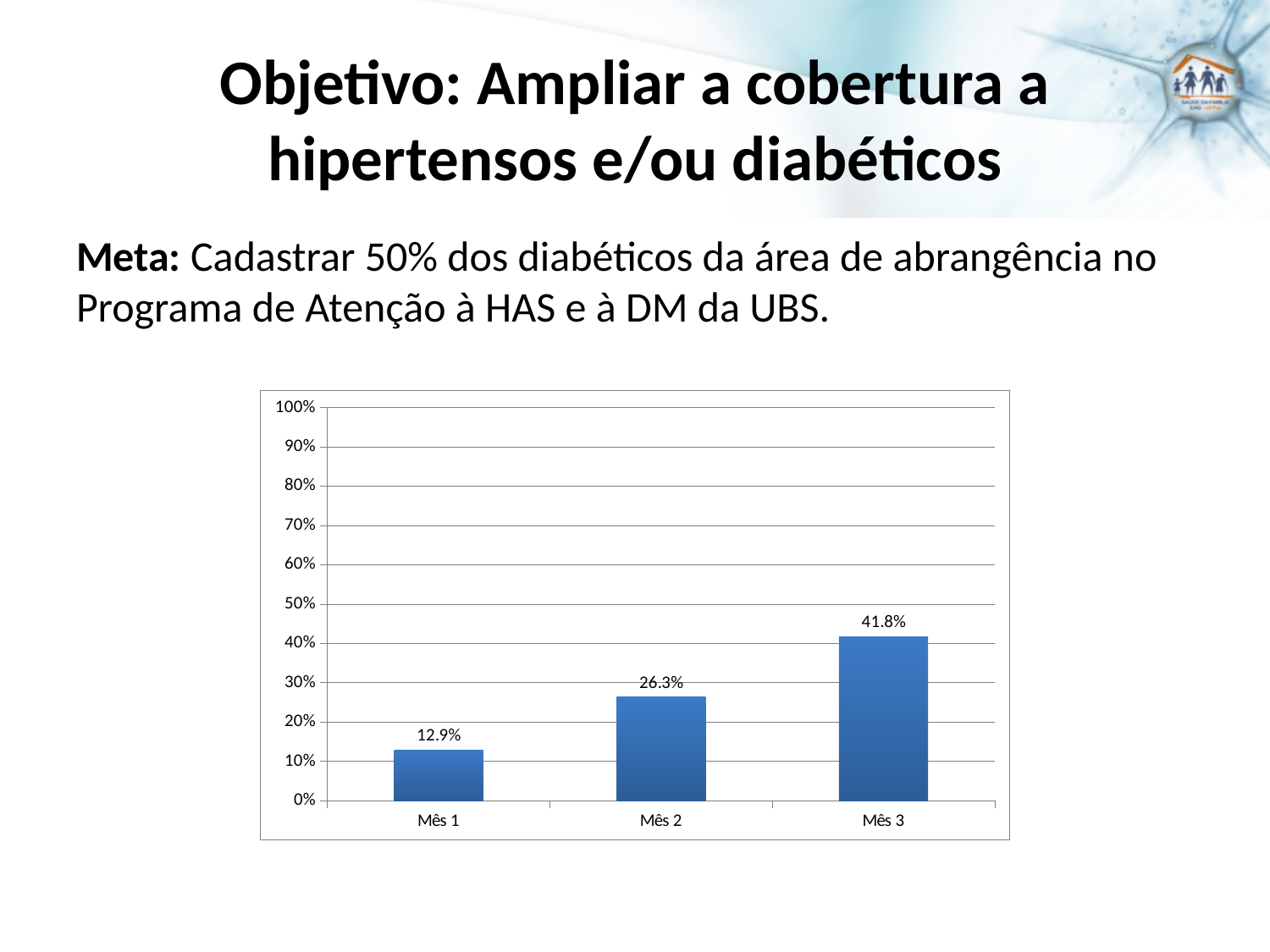
What is the difference between the values for Mês 2 and Mês 1? 13.4% What is the value for Mês 3? 41.8% Which month has the highest value? Mês 3 Which month has the lowest value? Mês 1 What is the difference between the values for Mês 3 and Mês 1? 28.9% What kind of chart is shown on the slide? bar chart Is the value for Mês 3 greater or less than 50%? less Do the values rise or fall from Mês 1 to Mês 3? rise How many categories are shown on the x axis? 3 What is the value for Mês 2? 26.3% Which is larger, the value for Mês 2 or the value for Mês 3? Mês 3 What is the value for Mês 1? 12.9%